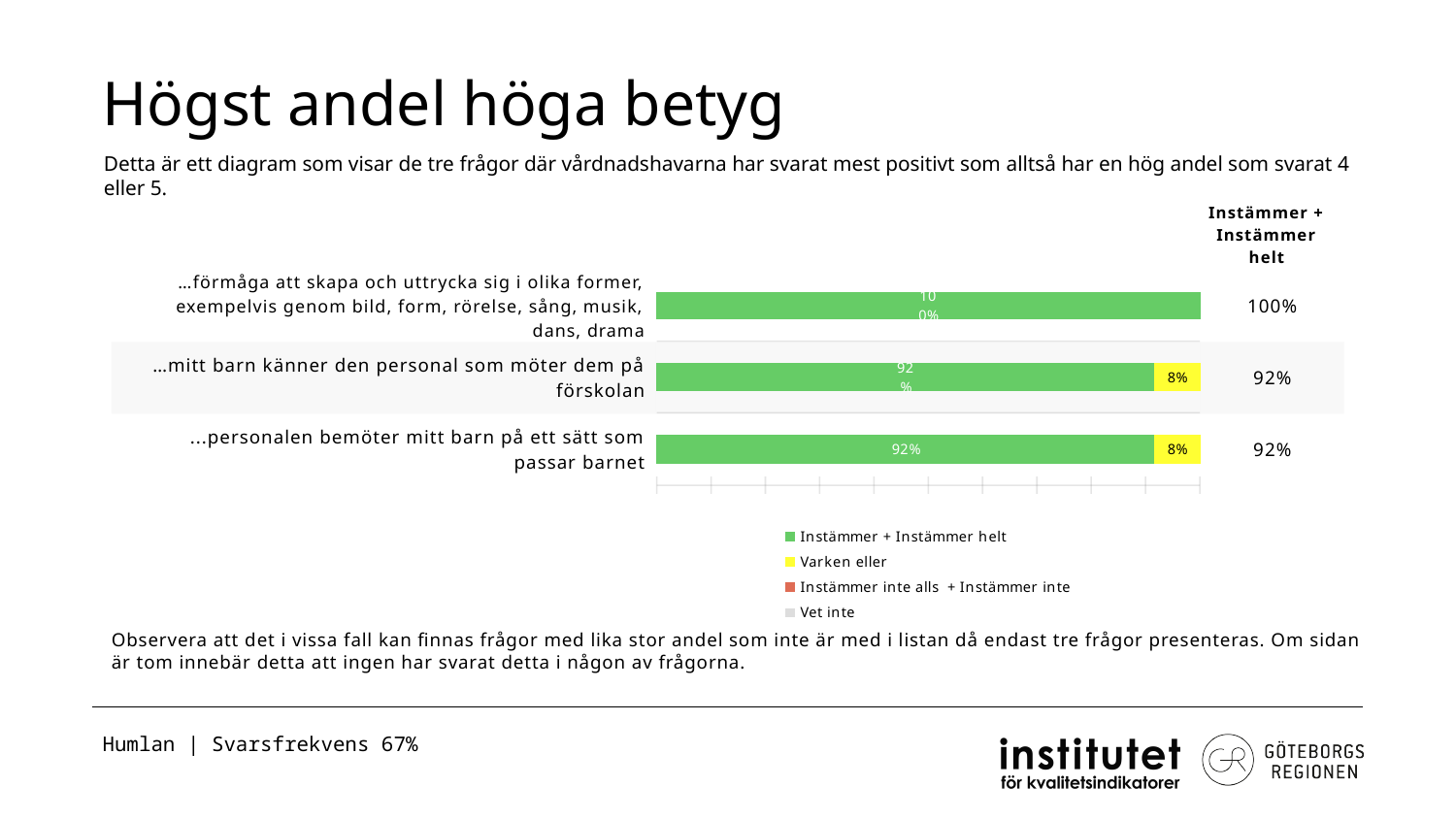
What is the title of the slide containing the chart? Högst andel höga betyg What is the 'Instämmer + Instämmer helt' share for '…mitt barn känner den personal som möter dem på förskolan'? 92% How many series does the legend list? 4 How many questions (categories) are plotted in the chart? 3 Which question has the highest 'Instämmer + Instämmer helt' share? …förmåga att skapa och uttrycka sig i olika former, exempelvis genom bild, form, rörelse, sång, musik, dans, drama What is the total of the stacked bar for '…mitt barn känner den personal som möter dem på förskolan'? 100% What colour represents 'Varken eller' in the legend? yellow What is the difference in 'Instämmer + Instämmer helt' share between '…förmåga att skapa och uttrycka sig i olika former…' and '…mitt barn känner den personal som möter dem på förskolan'? 8% What kind of chart is shown on the slide? bar chart What is the 'Varken eller' share for '...personalen bemöter mitt barn på ett sätt som passar barnet'? 8% Which is larger: the 'Instämmer + Instämmer helt' share for '…förmåga att skapa och uttrycka sig i olika former…' or for '...personalen bemöter mitt barn på ett sätt som passar barnet'? …förmåga att skapa och uttrycka sig i olika former… What is the 'Instämmer + Instämmer helt' share for '…förmåga att skapa och uttrycka sig i olika former, exempelvis genom bild, form, rörelse, sång, musik, dans, drama'? 100%